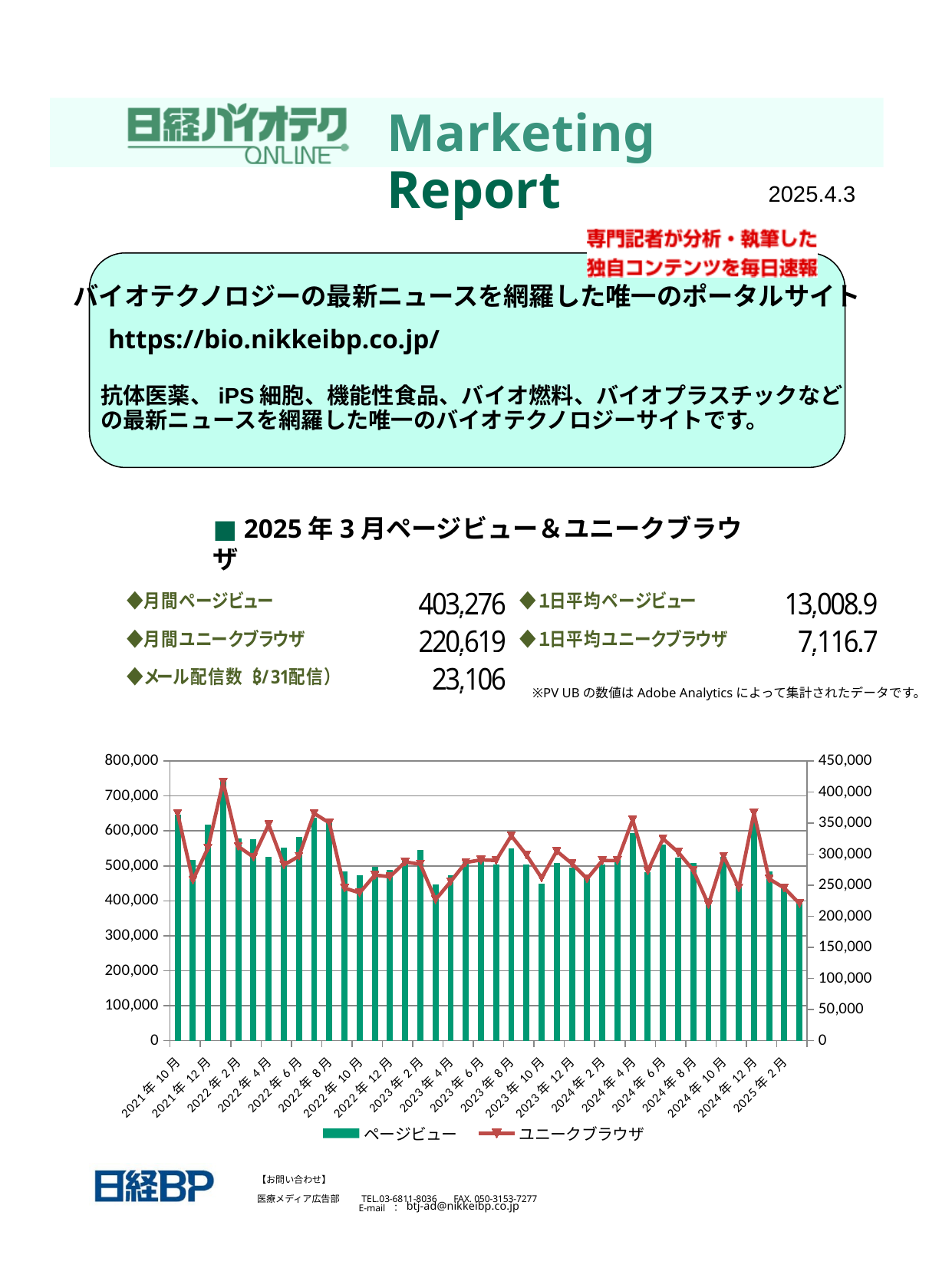
Which series is drawn as bars in the chart? ページビュー Which month has the larger ページビュー value, 2021年12月 or 2022年2月? 2021年12月 Is the ユニークブラウザ value for 2025年2月 greater or less than 300,000? less Do the ページビュー bars rise or fall from 2024年12月 to 2025年2月? fall Is the ユニークブラウザ value for 2022年2月 greater or less than 400,000? less Is the ページビュー value for 2024年12月 greater or less than 500,000? greater What are the two series named in the chart legend? ページビュー and ユニークブラウザ What kind of chart is shown on the slide? A combination bar and line chart How many series does the chart legend list? 2